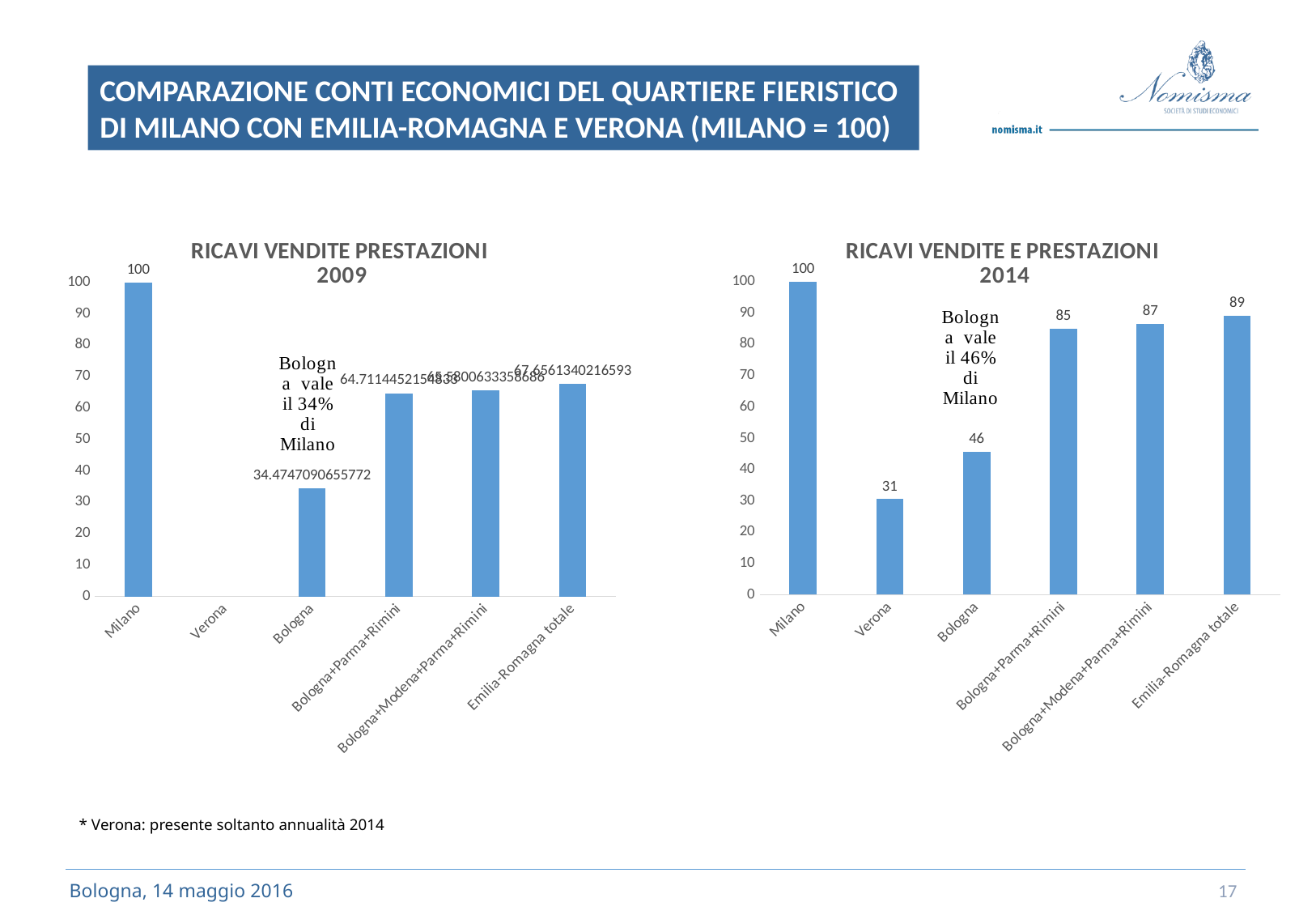
In the 2009 chart, what is the value for Milano? 100 In the 2014 chart, what is the value for Bologna? 46 In the 2009 chart, is the value for Bologna+Parma+Rimini greater or less than 60? greater In the 2014 chart, what is the difference between the values for Emilia-Romagna totale and Bologna? 43 In the 2014 chart, what is the value for Bologna+Modena+Parma+Rimini? 87 In the 2009 chart, which category has the highest value? Milano In the 2014 chart, which category has the lowest value? Verona What kind of chart is the 2014 chart? Bar chart In the 2009 chart (RICAVI VENDITE PRESTAZIONI 2009), what is the value for Bologna? 34.4747090655772 In the 2014 chart (RICAVI VENDITE E PRESTAZIONI 2014), what is the value for Verona? 31 In the 2014 chart, what is the value for Emilia-Romagna totale? 89 In the 2014 chart, which is larger: the value for Bologna+Parma+Rimini or the value for Bologna? Bologna+Parma+Rimini